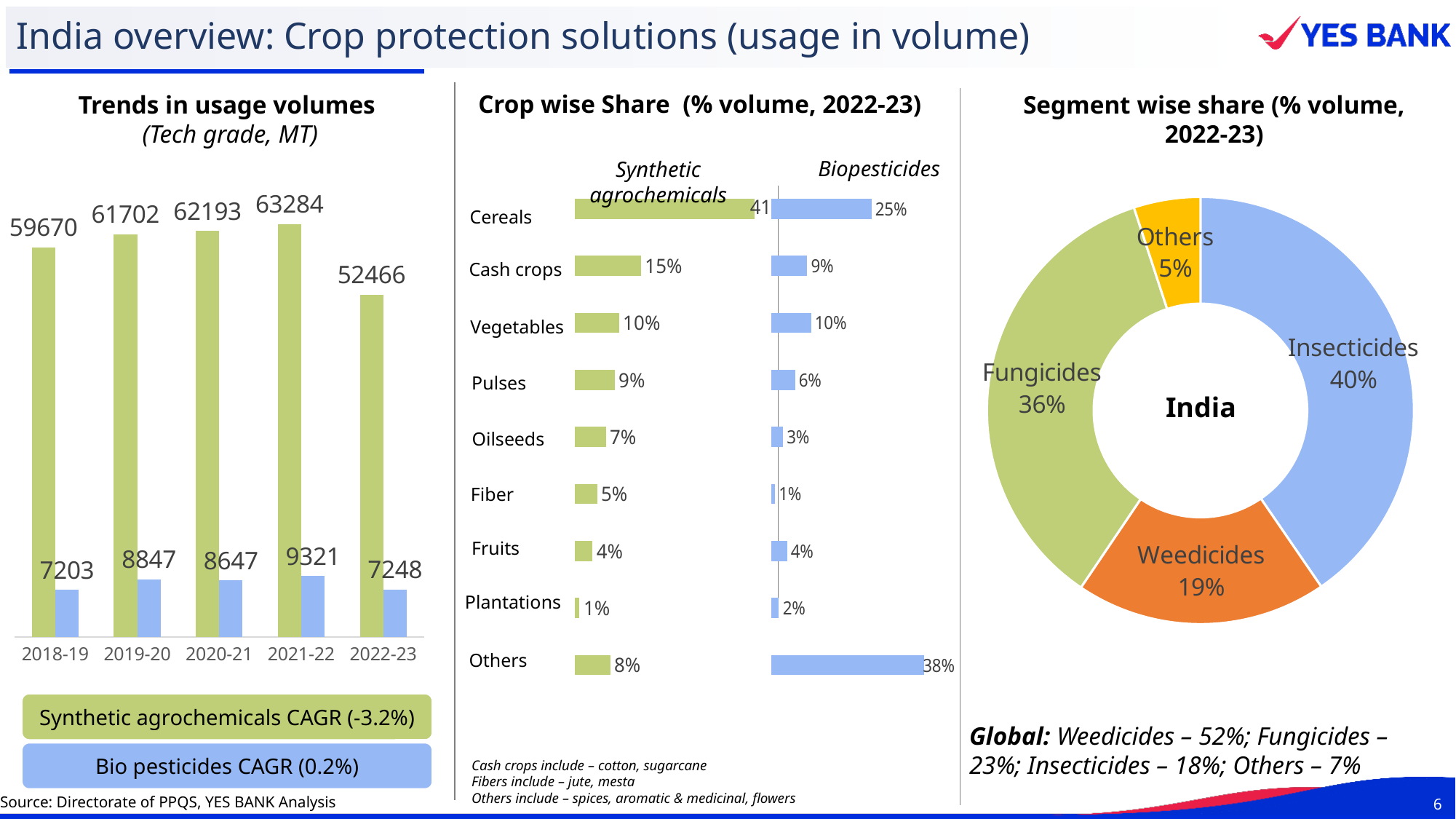
In the 'Crop wise Share' chart, is the synthetic agrochemicals share for Pulses larger or smaller than the biopesticides share for Pulses? Larger In the 'Trends in usage volumes' chart, how many years are shown on the x axis? 5 In the 'Trends in usage volumes' chart, what is the synthetic agrochemicals value for 2021-22? 63284 In the 'Crop wise Share' chart, which crop has the highest biopesticides share? Others In the 'Crop wise Share' chart, what is the biopesticides share for Others? 38% In the 'Crop wise Share' chart, what is the synthetic agrochemicals share for Cash crops? 15% What kind of chart is 'Trends in usage volumes'? Bar chart In the 'Segment wise share' chart, what is the share for Fungicides? 36% In the 'Trends in usage volumes' chart, what is the bio pesticides value for 2019-20? 8847 In the 'Trends in usage volumes' chart, which year has the lowest synthetic agrochemicals value? 2022-23 In the 'Trends in usage volumes' chart, what is the difference between the synthetic agrochemicals values for 2021-22 and 2022-23? 10818 What kind of chart is 'Segment wise share'? Donut chart